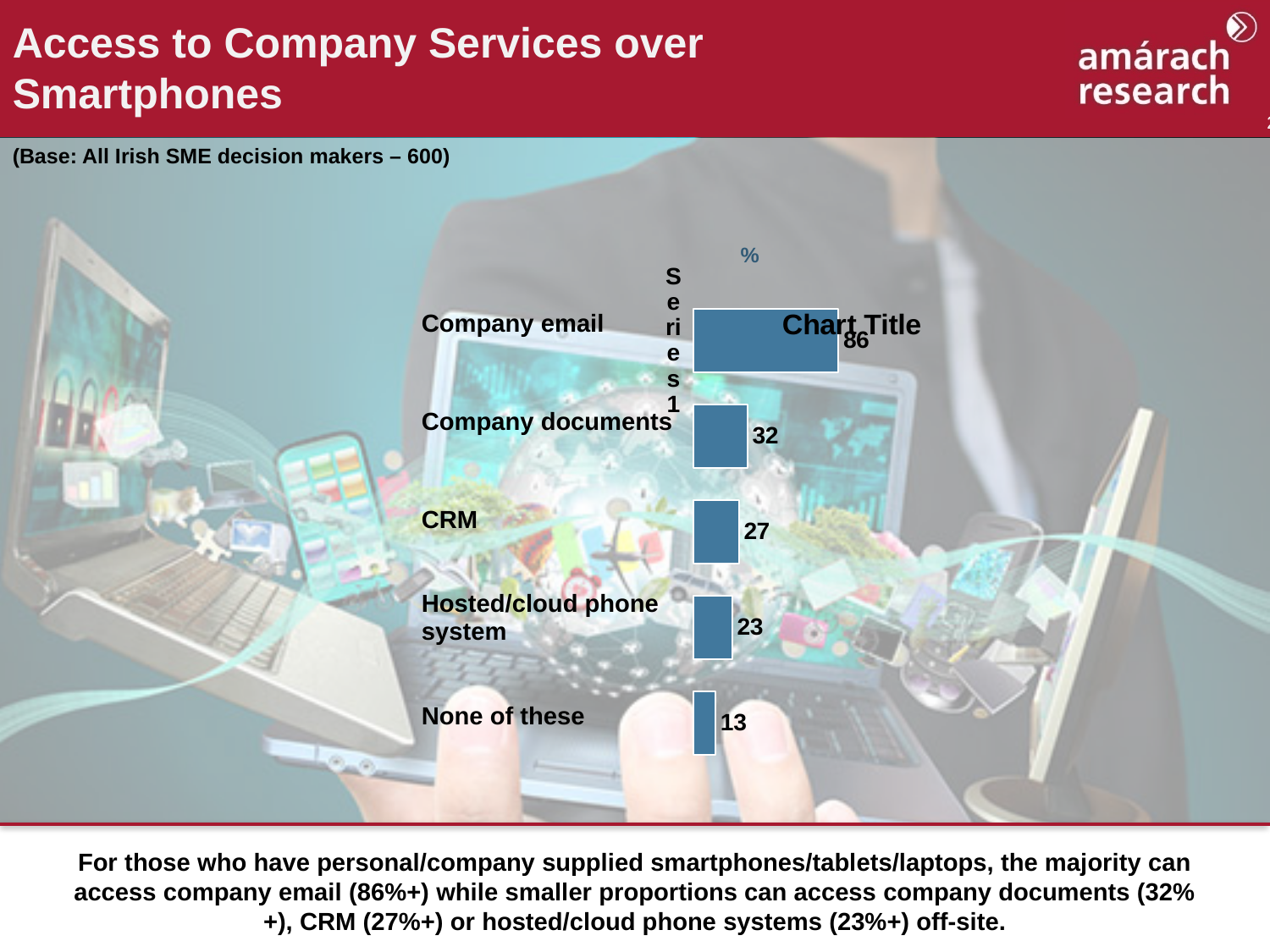
Which category has the highest value? Company email What is the value for None of these? 13 How many categories are shown in the chart? 5 What is the value for Company email? 86 Which is larger, the value for CRM or the value for Hosted/cloud phone system? CRM What is the difference between the values for Company email and Company documents? 54 What is the value for Hosted/cloud phone system? 23 What is the value for CRM? 27 What is the title shown on the chart? Chart Title What kind of chart is shown on the slide? Bar chart Which category has the lowest value? None of these What is the value for Company documents? 32